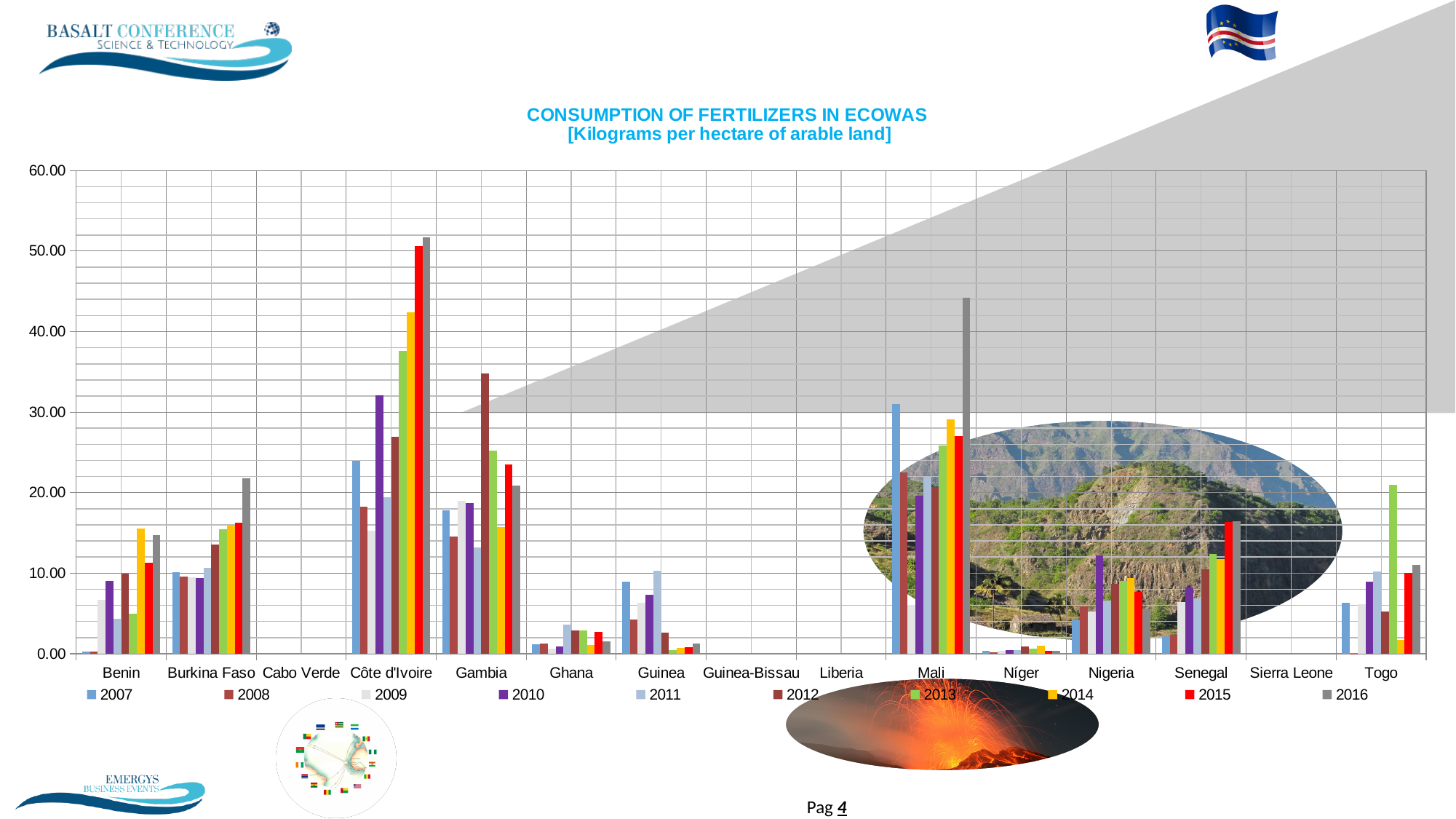
Which is larger, the 2007 value for Mali or the 2007 value for Benin? Mali Is the value for Ghana in 2011 greater or less than 10? less How many series does the legend list? 10 How many countries are shown on the x axis? 15 Is the value for Gambia in 2008 greater or less than 30? less Which country has the highest bar for 2015? Côte d'Ivoire Is the value for Mali in 2016 greater or less than 40? greater Which is larger, the 2008 value for Gambia or the 2008 value for Ghana? Gambia What is the title of the chart? CONSUMPTION OF FERTILIZERS IN ECOWAS [Kilograms per hectare of arable land] Which country has the highest bar for 2016? Côte d'Ivoire What kind of chart is shown on the slide? bar chart